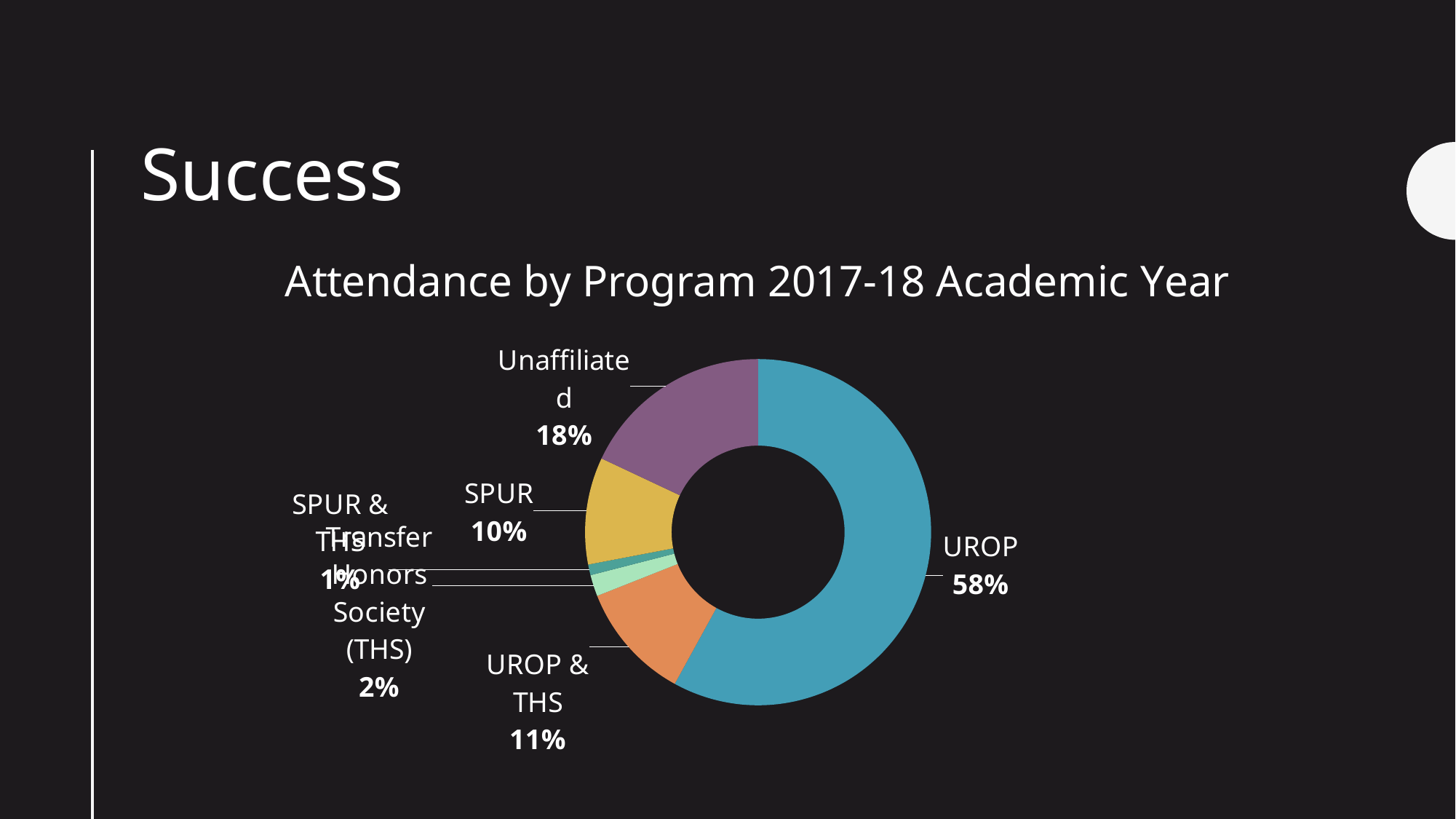
What percentage of attendance is attributed to SPUR? 10% What percentage of attendance is attributed to UROP? 58% What kind of chart is shown on the slide? Pie (doughnut) chart How many program categories are shown in the chart? 6 Which has a larger share of attendance, SPUR or UROP & THS? UROP & THS Which program has the smallest share of attendance? SPUR & THS How many percentage points larger is the UROP share than the Unaffiliated share? 40 What is the title of the chart? Attendance by Program 2017-18 Academic Year What percentage of attendance is attributed to Transfer Honors Society (THS)? 2% Which program has the largest share of attendance? UROP What percentage of attendance is attributed to UROP & THS? 11% What share of attendance is Unaffiliated? 18%